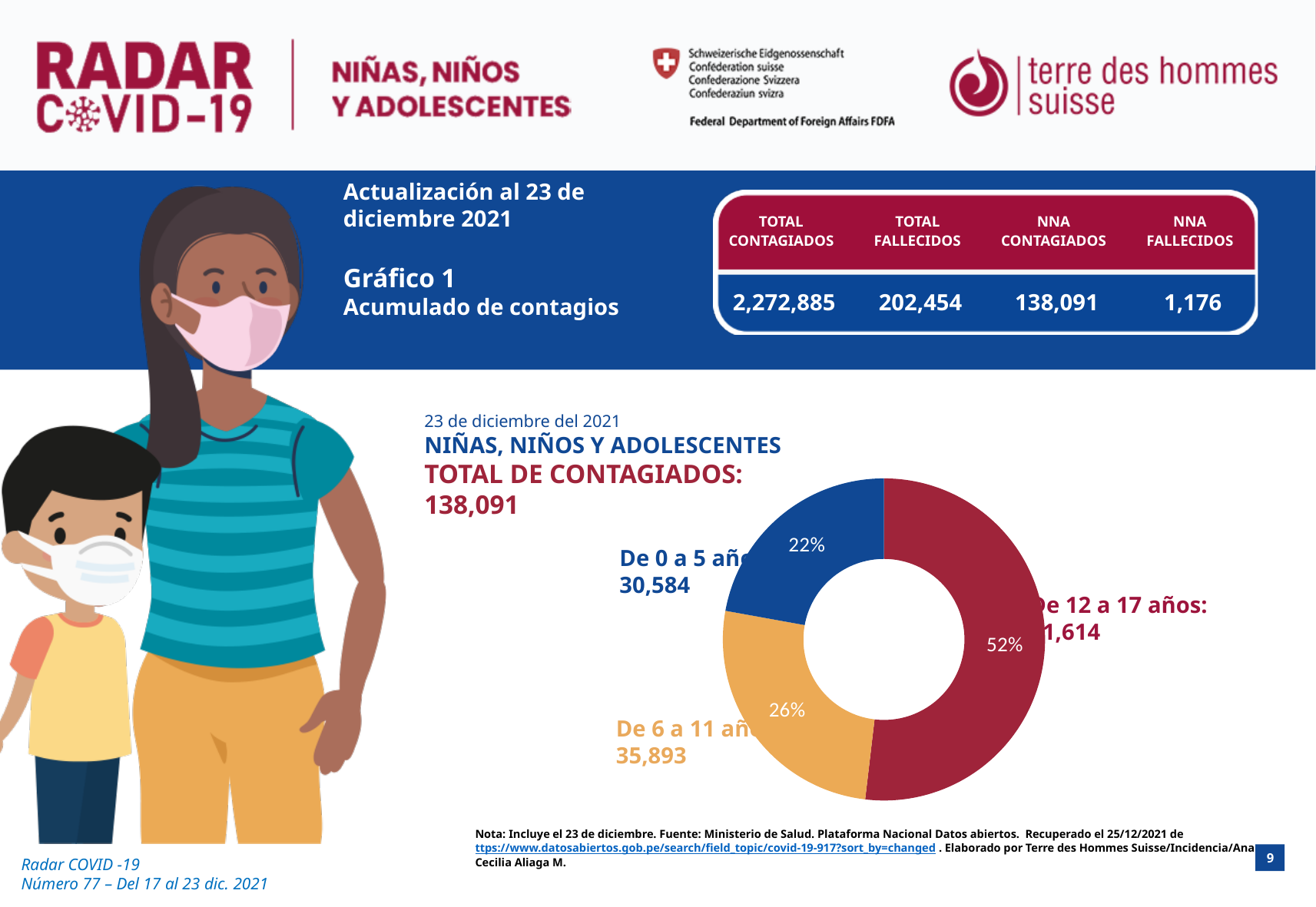
How many age-group slices does the donut chart have? 3 What is the number of contagiados shown for the 'De 0 a 5 años' group? 30,584 What percentage of the donut chart corresponds to the 'De 0 a 5 años' group? 22% What is the number of contagiados shown for the 'De 6 a 11 años' group? 35,893 What is the difference in contagiados between the 'De 6 a 11 años' and 'De 0 a 5 años' groups? 5,309 What percentage of the donut chart corresponds to the 'De 6 a 11 años' group? 26% What kind of chart is shown on the slide? Donut (pie) chart What total of contagiados is stated above the donut chart for niñas, niños y adolescentes? 138,091 What percentage of the donut chart corresponds to the 'De 12 a 17 años' group? 52% Which age group has the largest share of the donut chart? De 12 a 17 años Which age group has the smallest share of the donut chart? De 0 a 5 años Which group has more contagiados, 'De 0 a 5 años' or 'De 6 a 11 años'? De 6 a 11 años